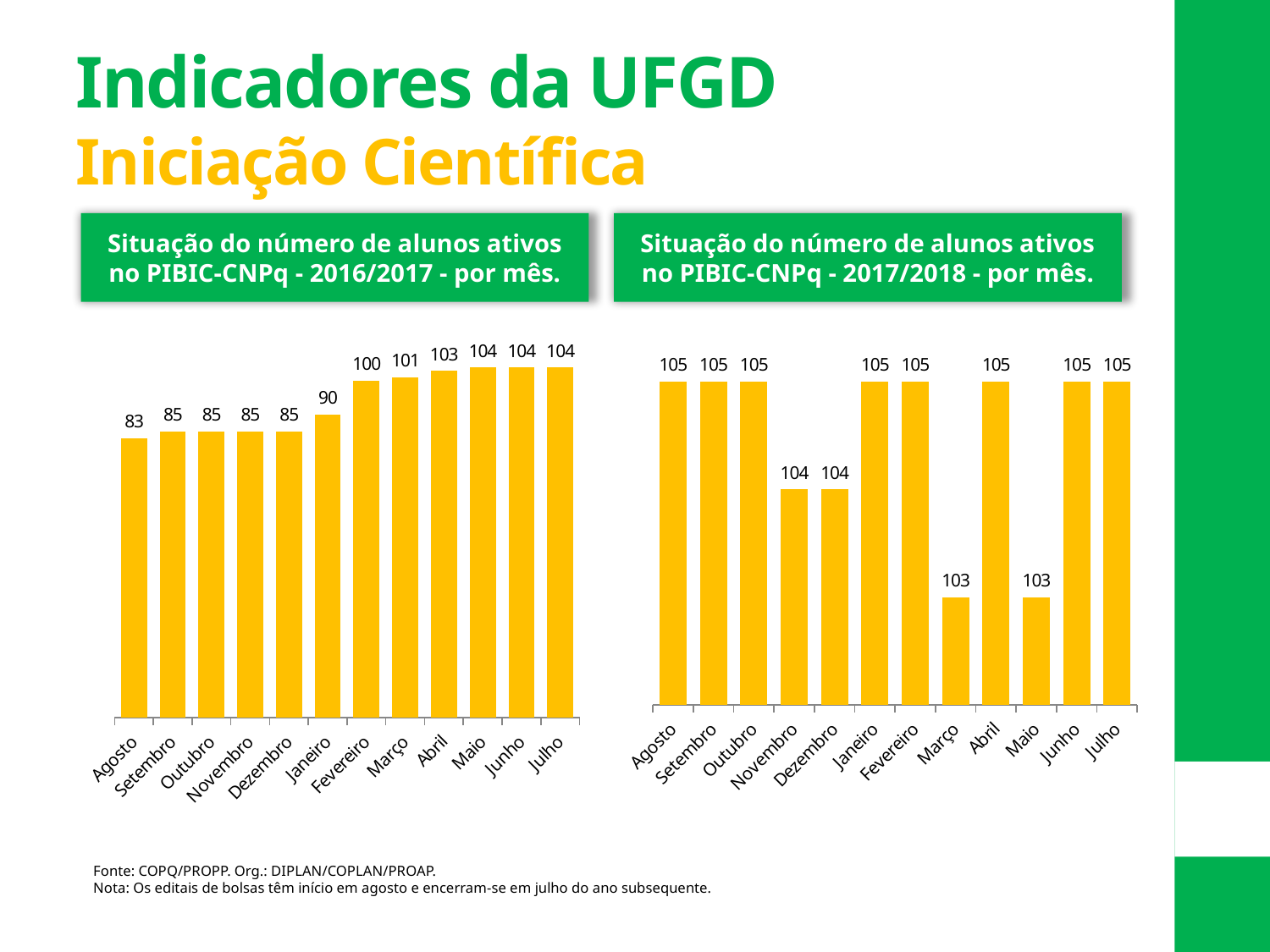
In the 2016/2017 chart (left), what is the value for Janeiro? 90 In the 2017/2018 chart (right), what is the value for Novembro? 104 In the 2016/2017 chart (left), what is the difference between the values for Julho and Agosto? 21 In the 2016/2017 chart (left), which is larger, the value for Fevereiro or the value for Dezembro? Fevereiro What kind of chart is the 2017/2018 chart (right)? Bar chart In the 2016/2017 chart (left), what is the value for Agosto? 83 In the 2016/2017 chart (left), which month has the lowest value? Agosto In the 2017/2018 chart (right), what is the difference between the values for Janeiro and Março? 2 In the 2017/2018 chart (right), what is the value for Março? 103 In the 2017/2018 chart (right), which is larger, the value for Abril or the value for Maio? Abril In the 2016/2017 chart (left), do the values generally rise or fall from Agosto to Julho? Rise How many months are shown in the 2016/2017 chart (left)? 12